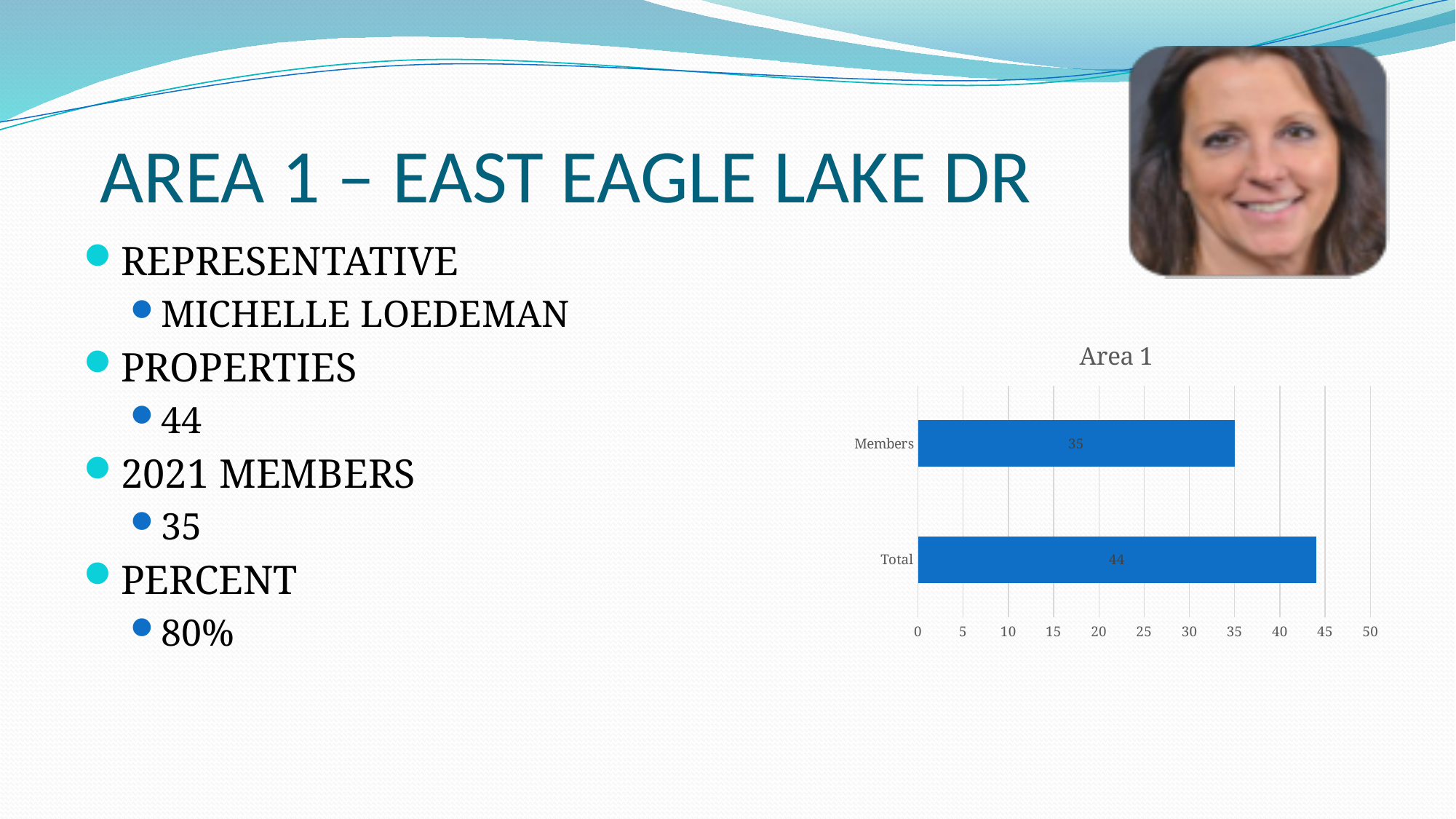
What is the maximum value shown on the chart's horizontal axis? 50 Is the value for Members greater or less than 40? less What is the value for Members in the chart? 35 What kind of chart is shown on the slide? bar chart Is the value for Total greater or less than 40? greater Which category has the lowest value in the chart? Members What is the value for Total in the chart? 44 Which category has the highest value in the chart? Total How many categories are shown in the chart? 2 What is the title of the chart? Area 1 Which is larger in the chart, Members or Total? Total What is the difference between the Total and Members values in the chart? 9